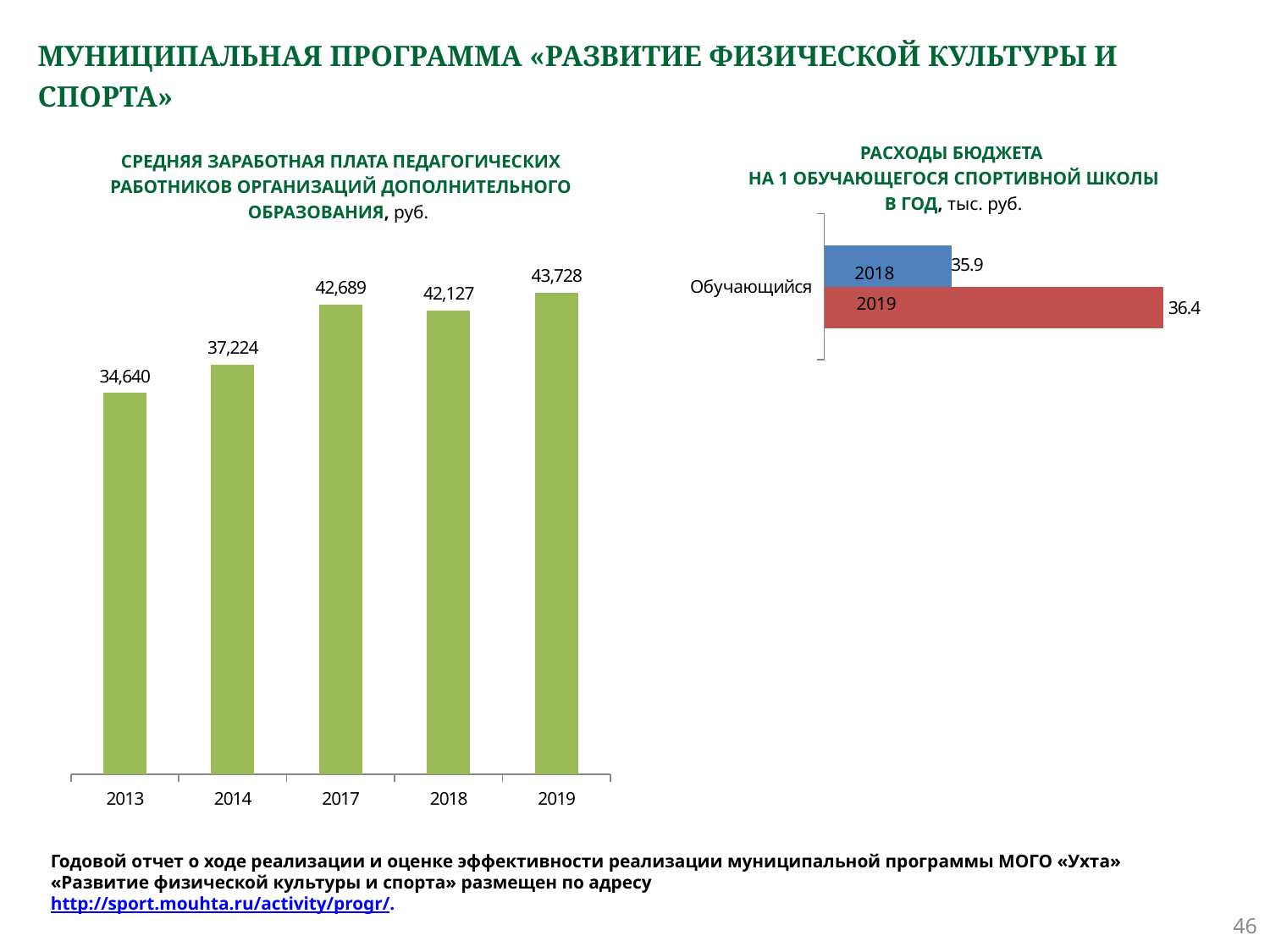
In the right chart (budget expenses per student of a sports school), what is the value for 2019? 36.4 In the left chart (average salary of teaching staff), which year has the lowest value? 2013 In the left chart (average salary of teaching staff), what is the value for 2019? 43,728 How many years (bars) are shown in the left chart (average salary of teaching staff)? 5 In the left chart (average salary of teaching staff), what is the value for 2013? 34,640 What type of chart is the left chart (average salary of teaching staff)? bar chart In the left chart (average salary of teaching staff), which is larger: the value for 2017 or for 2018? 2017 In the right chart (budget expenses per student of a sports school), what is the difference between the 2019 and 2018 values? 0.5 In the left chart (average salary of teaching staff), which year has the highest value? 2019 In the right chart (budget expenses per student of a sports school), what is the value for 2018? 35.9 In the left chart (average salary of teaching staff), what is the difference between the 2019 and 2013 values? 9,088 In the right chart (budget expenses per student of a sports school), what unit is stated in the title? тыс. руб.